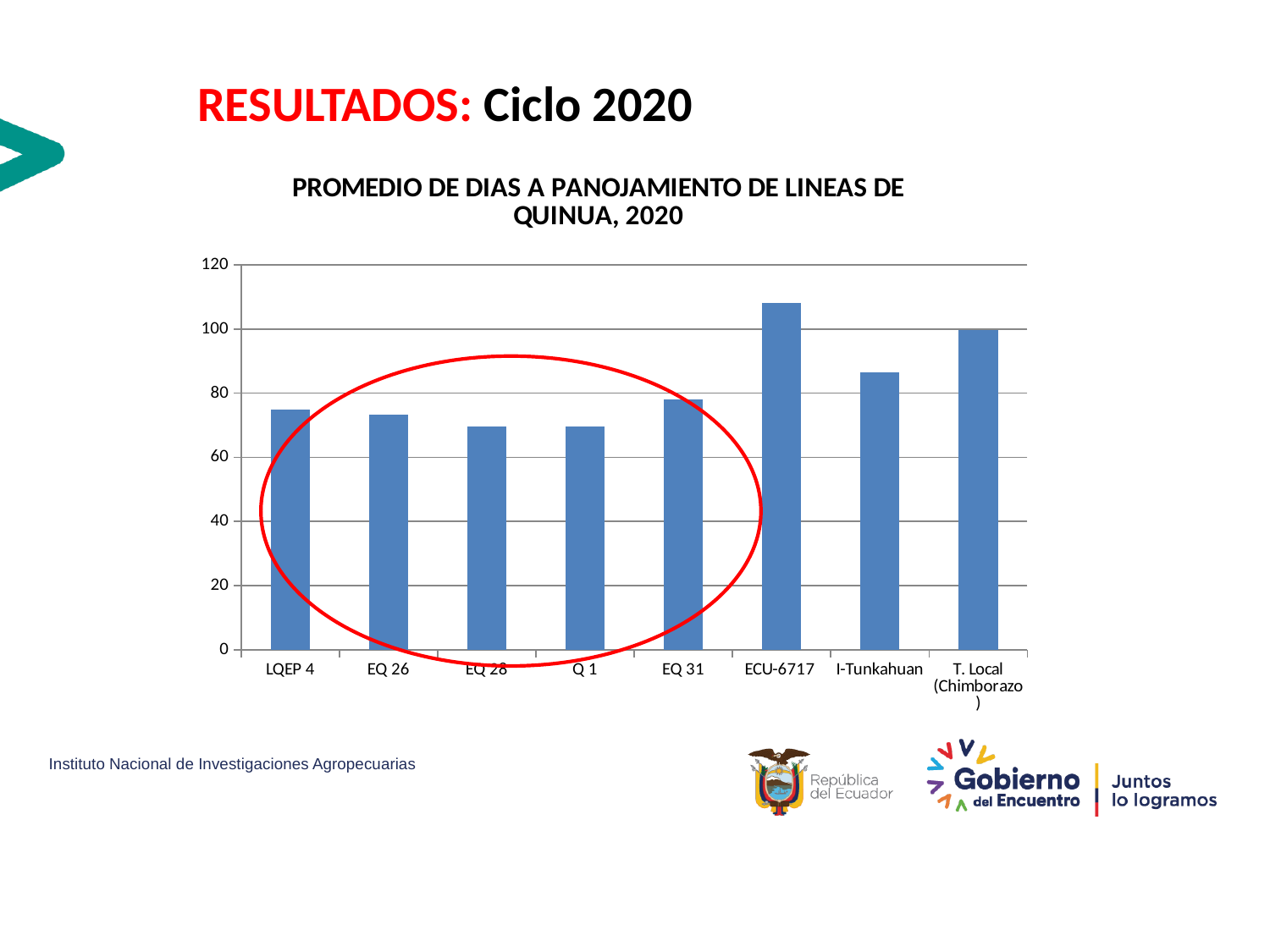
Which has a larger value, EQ 31 or Q 1? EQ 31 How many quinoa lines (categories) are plotted on the chart? 8 Is the value for ECU-6717 greater or less than 100? greater Is the value for LQEP 4 greater or less than 80? less Which has a larger value, T. Local (Chimborazo) or I-Tunkahuan? T. Local (Chimborazo) Is the value for I-Tunkahuan greater or less than 80? greater Which has a larger value, ECU-6717 or I-Tunkahuan? ECU-6717 What kind of chart is shown on the slide? Bar chart What is the title of the chart? PROMEDIO DE DIAS A PANOJAMIENTO DE LINEAS DE QUINUA, 2020 How many bars are enclosed by the red circle on the chart? 5 Which line has the highest average days to panicle emergence? ECU-6717